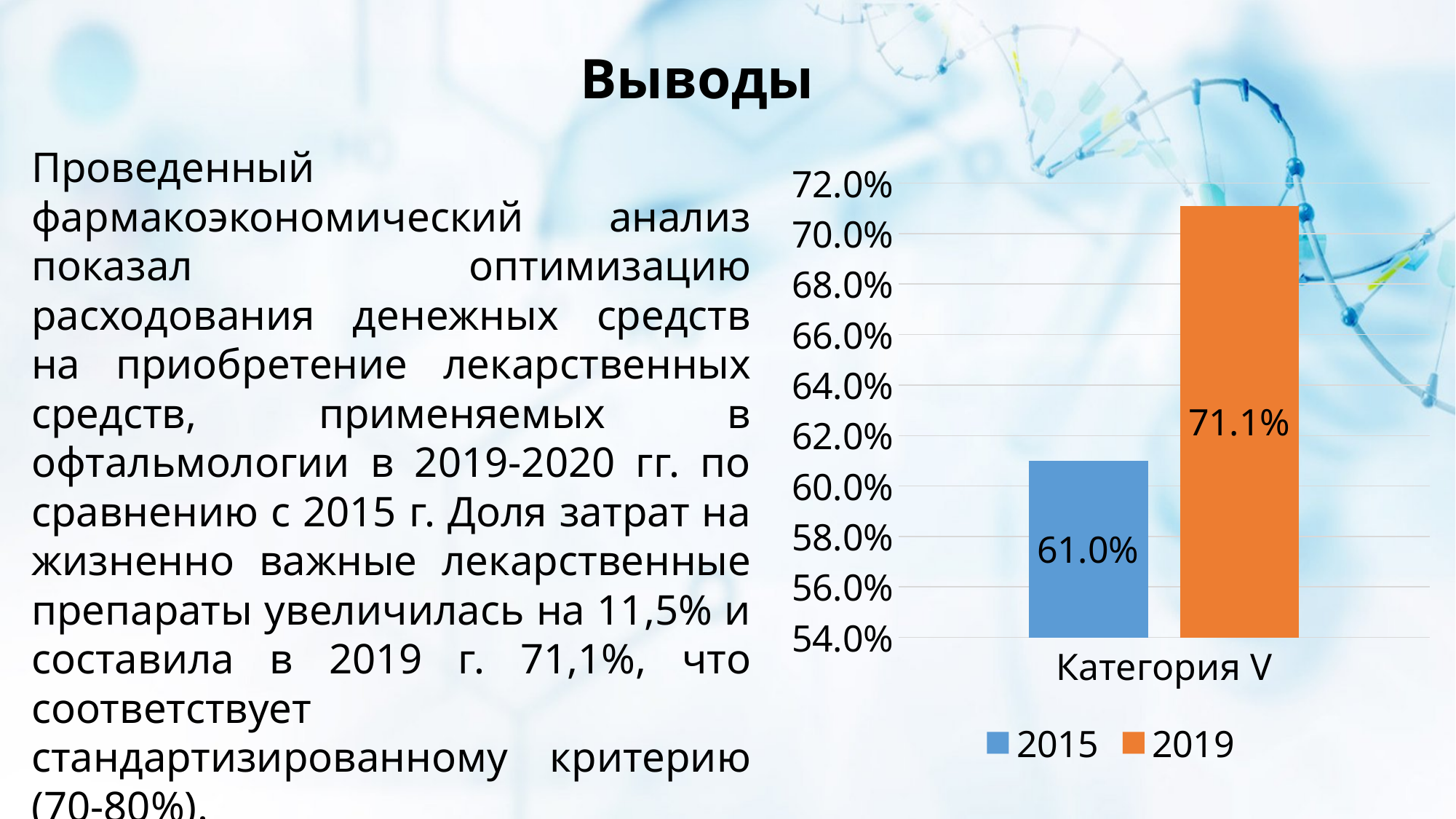
What kind of chart is shown on the slide? Bar chart Which series has the lowest value in the chart? 2015 Which series has the higher value, 2015 or 2019? 2019 Is the value for 2019 greater or less than 70.0%? greater Is the value for 2015 greater or less than 60.0%? greater How many categories are shown on the x axis? 1 What is the value for 2019 in the chart? 71.1% Which series has the highest value in the chart? 2019 What is the difference between the 2019 value and the 2015 value? 10.1% What is the value for 2015 in the chart? 61.0% What is the category label on the x axis of the chart? Категория V How many series does the legend list? 2